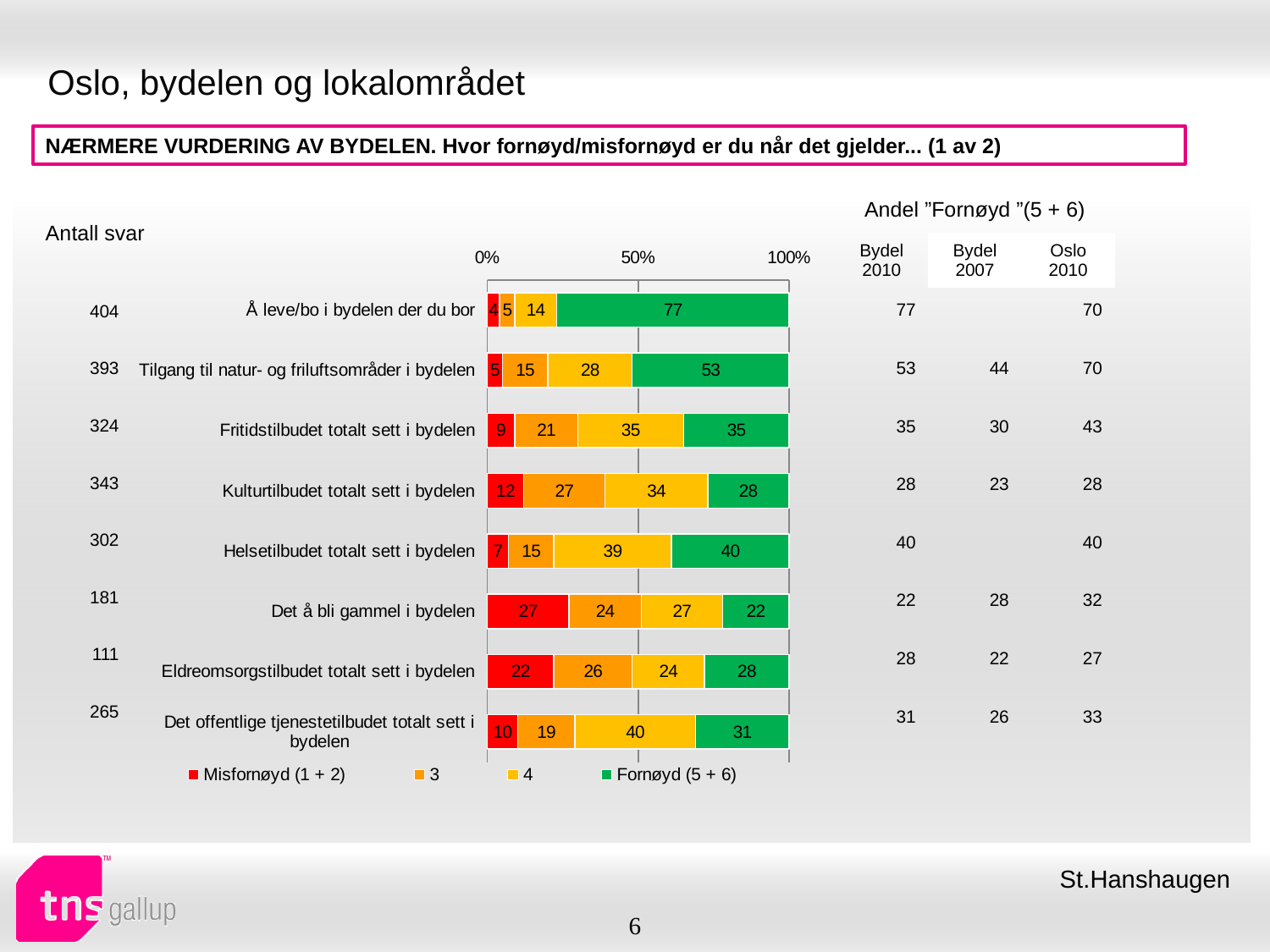
What is the difference between the Fornøyd (5 + 6) values for "Tilgang til natur- og friluftsområder i bydelen" and "Fritidstilbudet totalt sett i bydelen"? 18 What is the value of the series "4" for "Det offentlige tjenestetilbudet totalt sett i bydelen"? 40 How many categories are shown in the chart? 8 What is the value of the Misfornøyd (1 + 2) series for "Det å bli gammel i bydelen"? 27 What is the value of the series "3" for "Kulturtilbudet totalt sett i bydelen"? 27 What is the value of the Fornøyd (5 + 6) series for "Å leve/bo i bydelen der du bor"? 77 What kind of chart is shown on the slide? Stacked bar chart Which has a larger Misfornøyd (1 + 2) value: "Eldreomsorgstilbudet totalt sett i bydelen" or "Helsetilbudet totalt sett i bydelen"? Eldreomsorgstilbudet totalt sett i bydelen How many series does the legend list? 4 Which category has the lowest value for the Fornøyd (5 + 6) series? Det å bli gammel i bydelen Which category has the highest value for the Fornøyd (5 + 6) series? Å leve/bo i bydelen der du bor What is the total of the stacked bar for "Fritidstilbudet totalt sett i bydelen"? 100